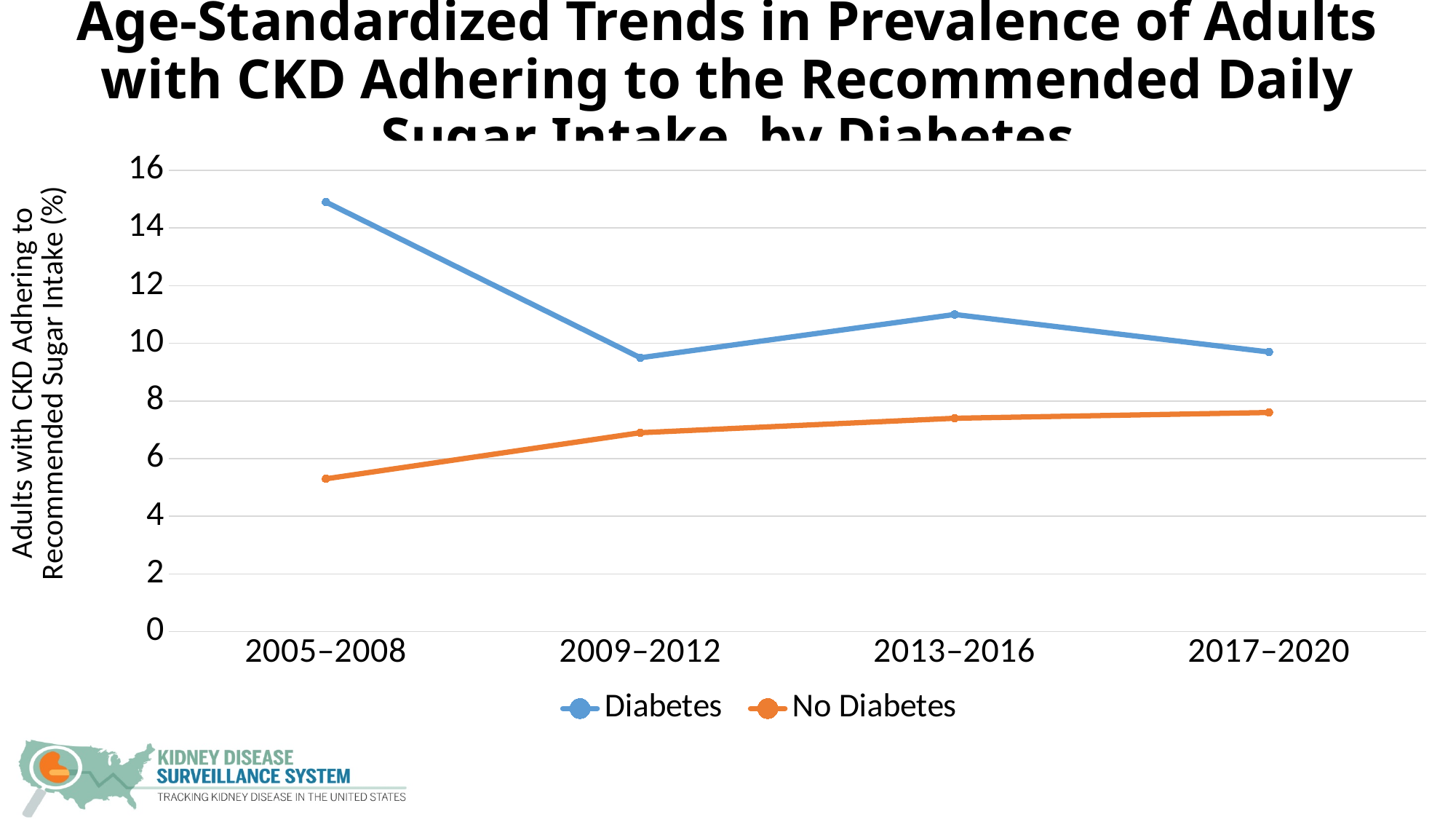
In which period is the Diabetes series at its highest? 2005–2008 What kind of chart is shown on the slide? Line chart In 2005–2008, which series has the larger value, Diabetes or No Diabetes? Diabetes How many series does the legend list? 2 Does the No Diabetes series rise or fall from 2005–2008 to 2017–2020? Rise Is the value for No Diabetes in 2017–2020 greater or less than 8? less Is the value for Diabetes in 2013–2016 greater or less than 10? greater How many time periods are shown on the x axis? 4 Is the value for Diabetes in 2005–2008 greater or less than 14? greater In which period is the No Diabetes series at its lowest? 2005–2008